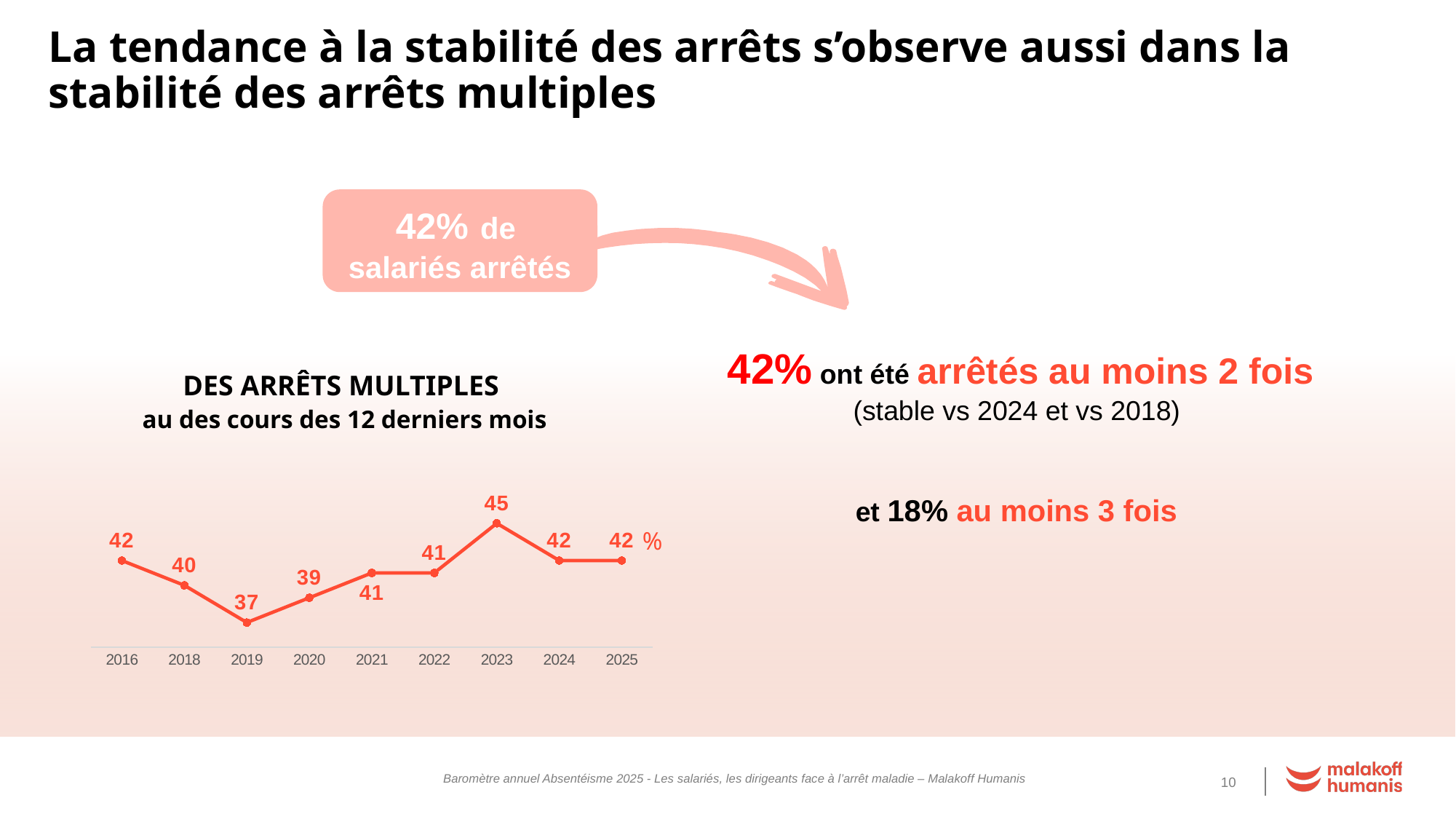
What is the value for 2023 in the chart? 45 Which year has the highest value in the chart? 2023 What type of chart is shown on the slide? line chart How many years are plotted on the x axis of the chart? 9 Which is larger, the value for 2018 or the value for 2022? 2022 Do the values rise or fall between 2019 and 2023? rise What is the title of the chart? DES ARRÊTS MULTIPLES au des cours des 12 derniers mois What is the difference between the values for 2023 and 2019? 8 What is the value for 2020 in the chart? 39 What is the value for 2019 in the chart? 37 What is the value for 2025 in the chart? 42 Which year has the lowest value in the chart? 2019